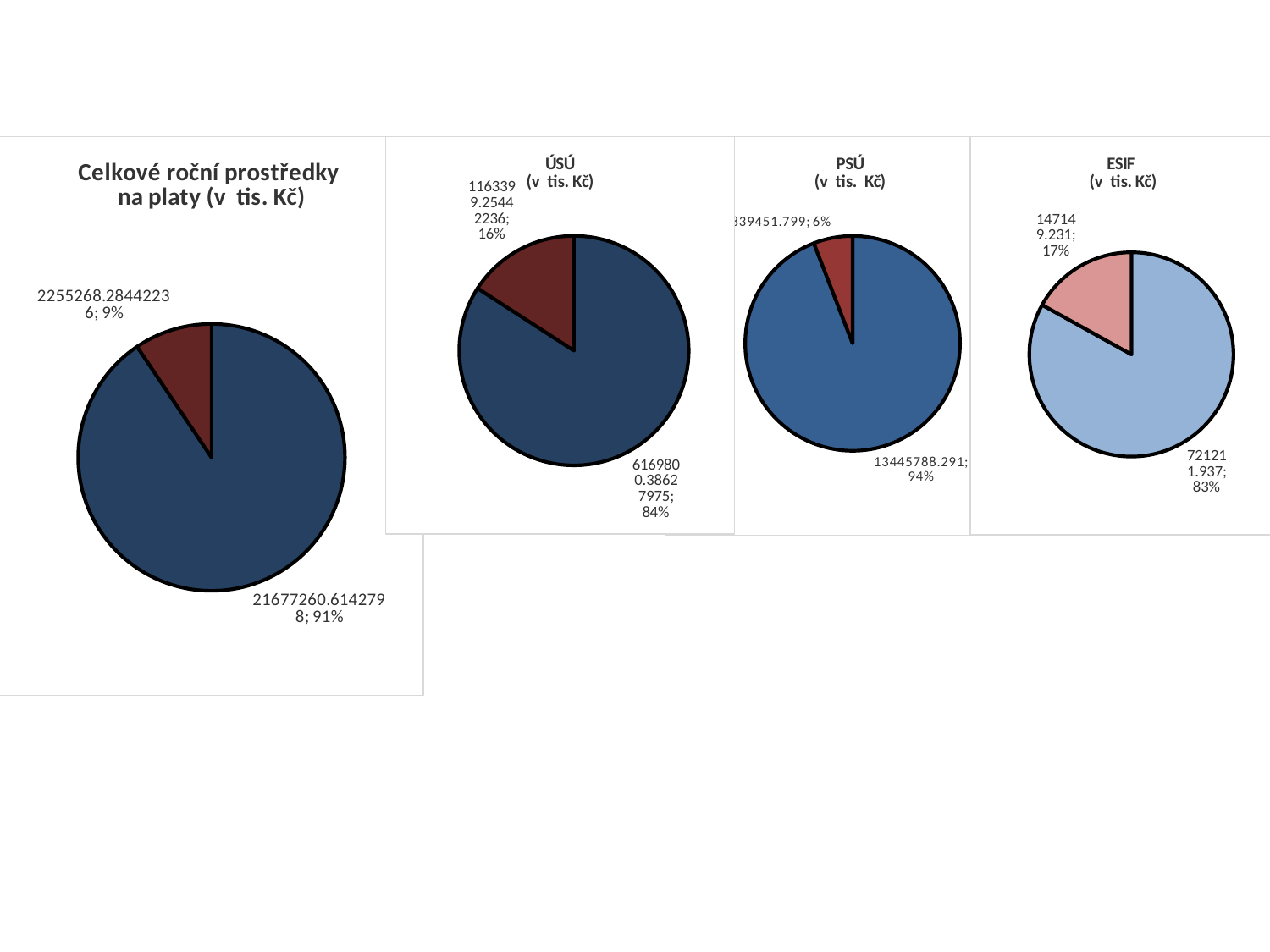
How many pie charts are shown on the slide? 4 How many slices does the 'ESIF (v tis. Kč)' pie chart have? 2 In the 'Celkové roční prostředky na platy' pie chart, what share does the smaller slice have? 9% In the 'ÚSÚ (v tis. Kč)' pie chart, what share does the smaller slice have? 16% In the 'PSÚ (v tis. Kč)' pie chart, what value is printed for the slice with 94%? 13445788.291 In the 'ESIF (v tis. Kč)' pie chart, what share does the larger slice have? 83% Which pie chart has the smallest minor slice by percentage: ÚSÚ, PSÚ or ESIF? PSÚ What kind of chart is the 'Celkové roční prostředky na platy (v tis. Kč)' chart? pie chart